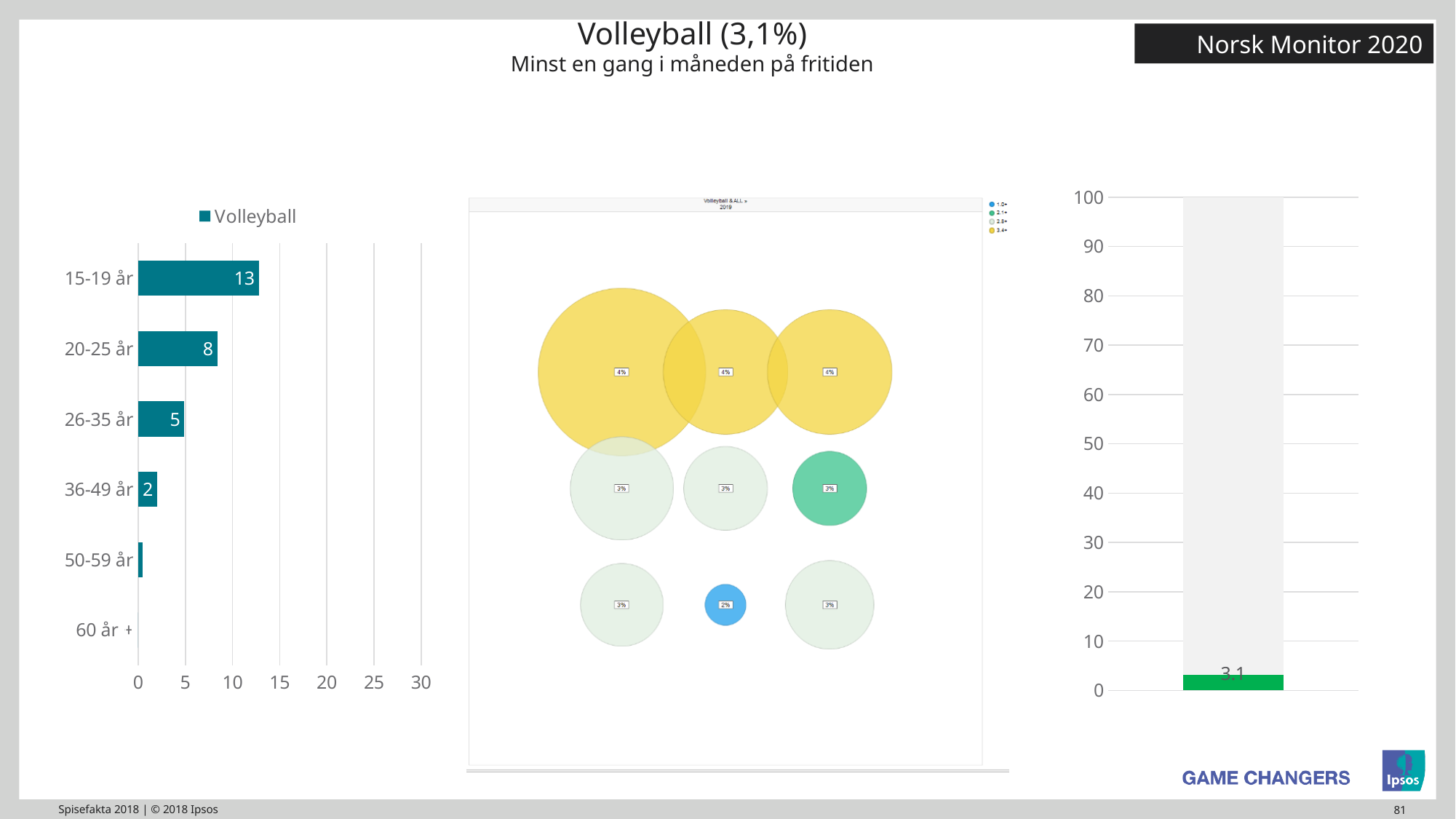
In the bar chart on the left, what is the value for the 15-19 år age group? 13 In the bar chart on the left, which age group has the highest value? 15-19 år In the bar chart on the left, is the value for 50-59 år greater or less than 5? less In the bar chart on the left, what is the value for the 36-49 år age group? 2 What kind of chart is the chart on the left of the slide? bar chart In the bar chart on the left, what is the value for the 20-25 år age group? 8 In the bar chart on the left, do the values rise or fall as the age groups get older from 15-19 år to 36-49 år? fall In the bar chart on the left, what is the difference between the values for 15-19 år and 20-25 år? 5 In the bar chart on the left, what is the value for the 26-35 år age group? 5 In the bar chart on the left, which is larger: the value for 26-35 år or the value for 36-49 år? 26-35 år How many age-group categories are shown in the bar chart on the left? 6 In the bar chart on the right of the slide, what value is printed on the bar? 3.1